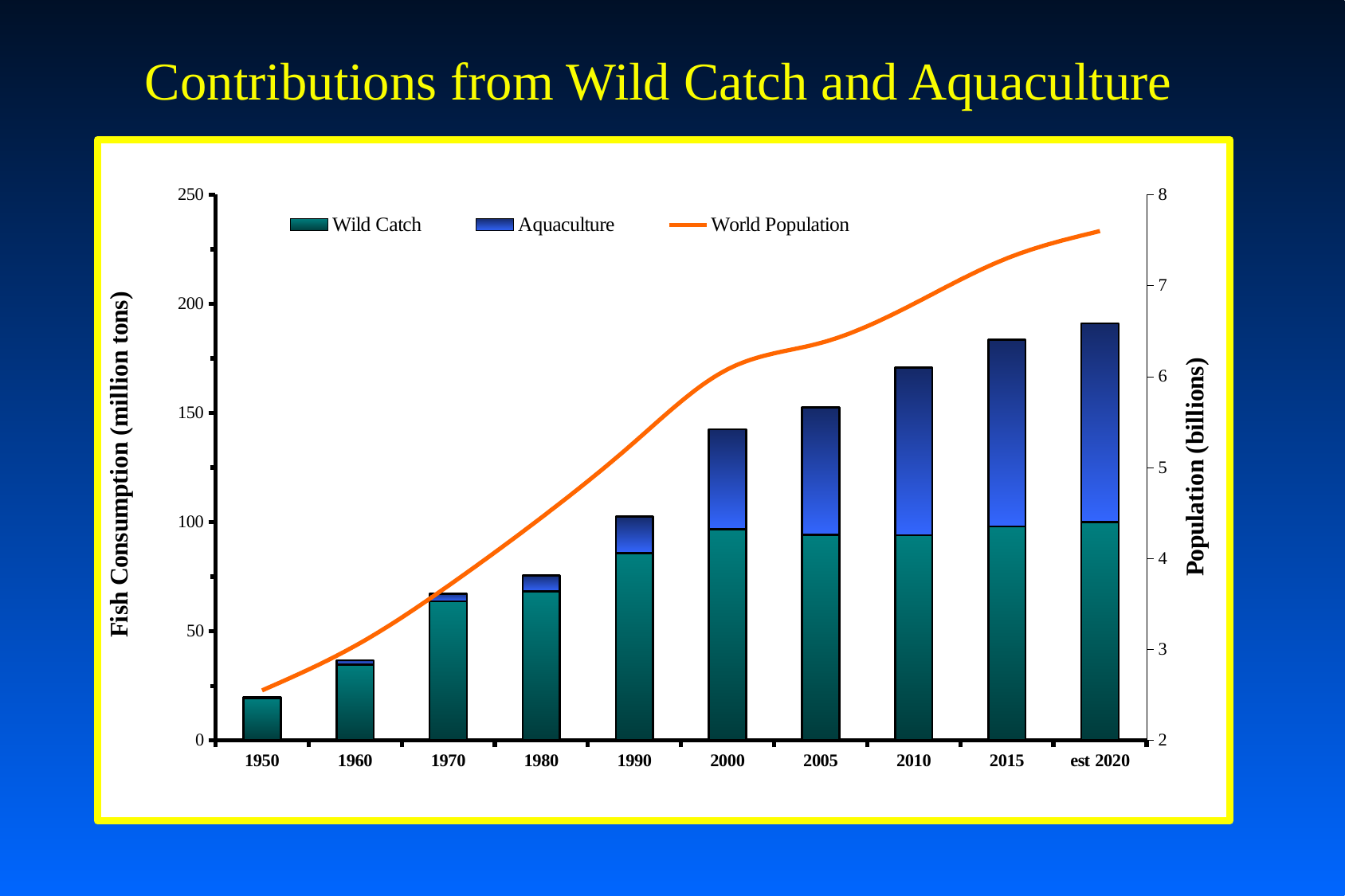
Is the total fish consumption bar for 2010 larger or smaller than the bar for 2000? larger What kind of chart is shown on the slide? A stacked bar chart combined with a line chart Which series is drawn as an orange line? World Population How many series does the legend list? 3 Which year has the lowest total fish consumption bar? 1950 How many year categories are shown on the x axis? 10 Is the total fish consumption for 1950 greater or less than 50 million tons? less Which year has the highest total fish consumption bar? est 2020 What is the label of the right-hand vertical axis? Population (billions) Does the World Population line rise or fall from 1950 to est 2020? rise Is the total fish consumption for est 2020 greater or less than 150 million tons? greater Is the World Population value for est 2020 greater or less than 7 billion? greater